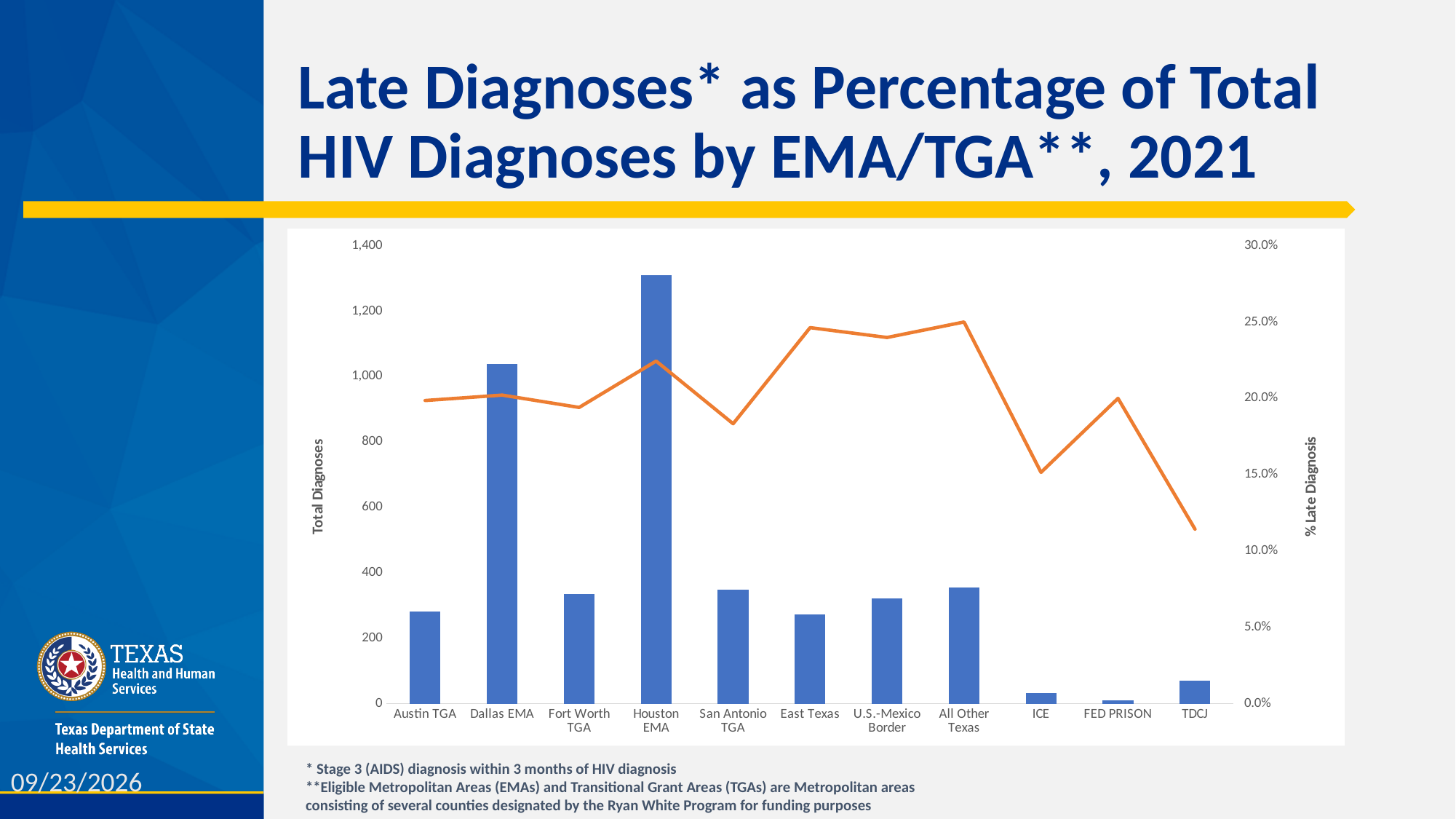
Is the % Late Diagnosis value for TDCJ greater or less than 15.0%? less What is the title of the left vertical axis? Total Diagnoses What kind of chart is shown on the slide? A combination bar and line chart Which category has the highest bar for Total Diagnoses? Houston EMA Which category has the lowest bar for Total Diagnoses? FED PRISON Which category has the lowest value on the % Late Diagnosis line? TDCJ Which has more Total Diagnoses, Dallas EMA or Houston EMA? Houston EMA Is the Total Diagnoses value for Dallas EMA greater or less than 1,000? greater Is the % Late Diagnosis value for Austin TGA greater or less than 15.0%? greater How many categories are shown along the x axis? 11